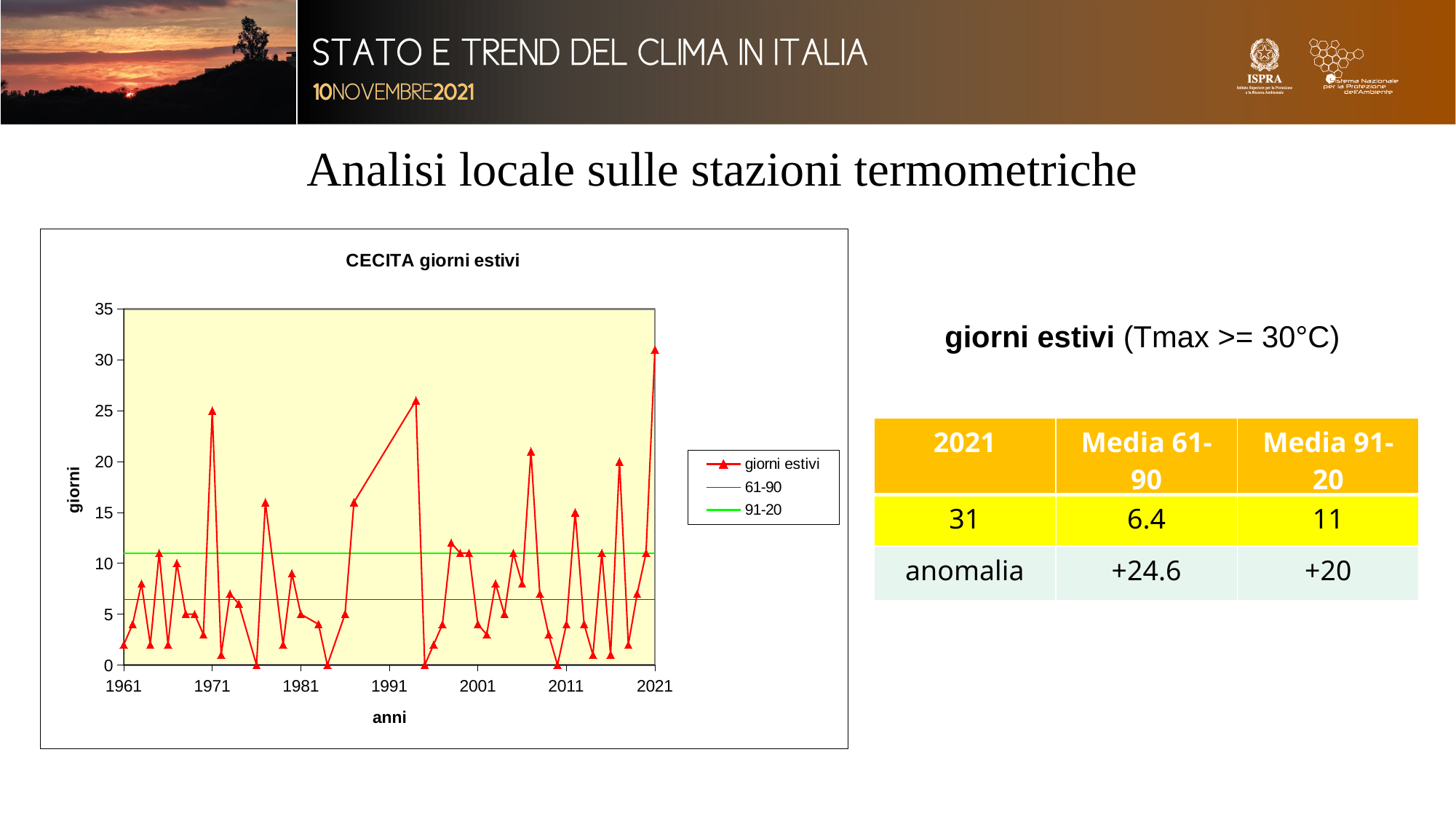
In the "CECITA giorni estivi" chart, what is the value of giorni estivi for 2021? 31 How many series does the legend of the "CECITA giorni estivi" chart list? 3 In the "CECITA giorni estivi" chart, is the value for 1961 greater or less than 5? less In the "CECITA giorni estivi" chart, which year has the highest number of giorni estivi? 2021 What are the three entries in the legend of the "CECITA giorni estivi" chart? giorni estivi, 61-90, 91-20 What is the label of the y axis of the "CECITA giorni estivi" chart? giorni In the "CECITA giorni estivi" chart, is the value for 2021 greater or less than 30? greater In the "CECITA giorni estivi" chart, which reference line is higher, 61-90 or 91-20? 91-20 In the "CECITA giorni estivi" chart, at what value does the 91-20 reference line sit? 11 What kind of chart is "CECITA giorni estivi"? line chart In the "CECITA giorni estivi" chart, is the value for 1971 greater or less than 20? greater In the "CECITA giorni estivi" chart, at what value does the 61-90 reference line sit? 6.4